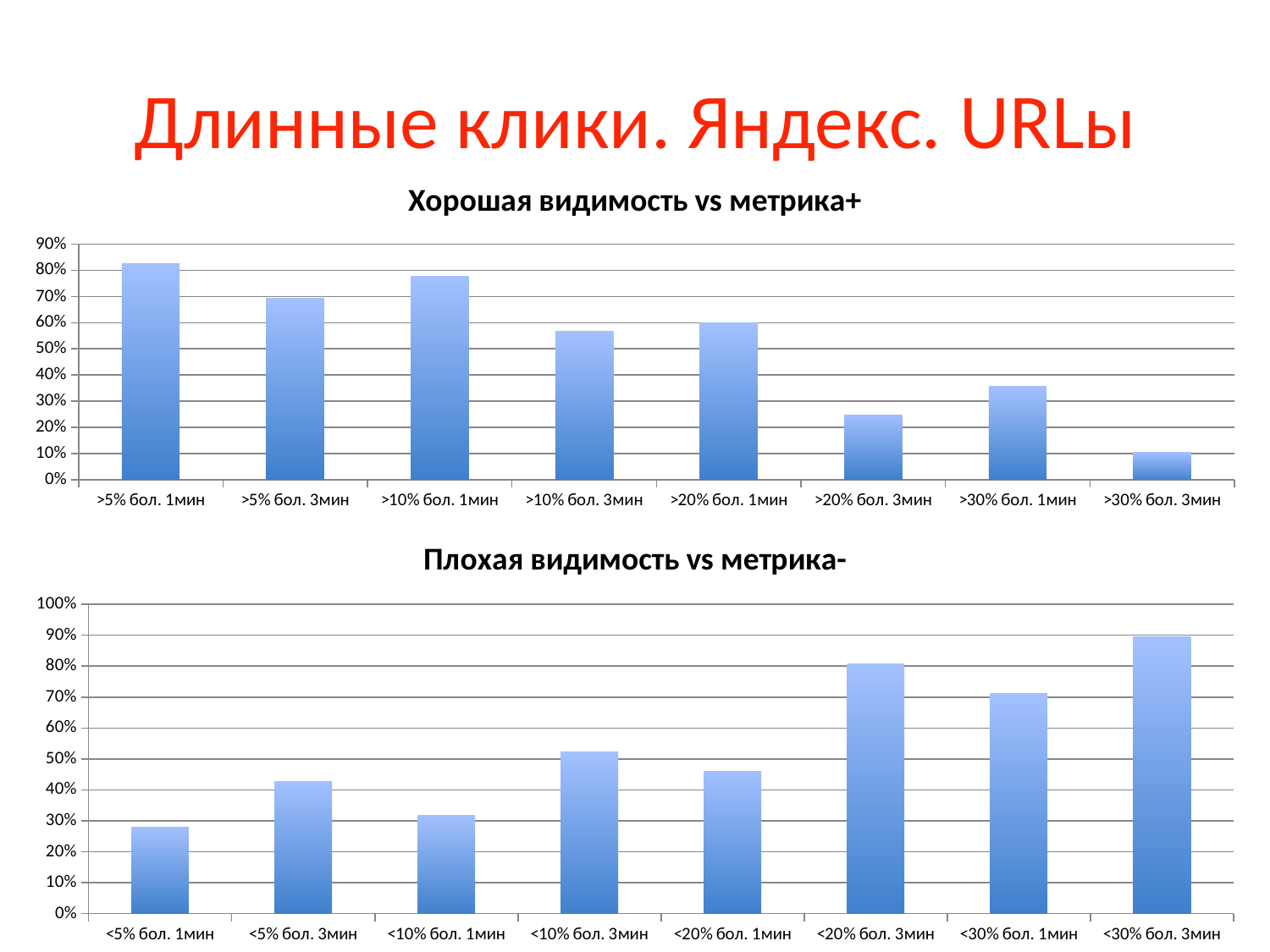
In the bottom chart "Плохая видимость vs метрика-", which is larger: the value for "<5% бол. 1мин" or the value for "<5% бол. 3мин"? <5% бол. 3мин What kind of chart is the top chart titled "Хорошая видимость vs метрика+"? bar chart In the top chart "Хорошая видимость vs метрика+", is the value for ">20% бол. 3мин" greater or less than 30%? less In the bottom chart "Плохая видимость vs метрика-", which category has the highest value? <30% бол. 3мин In the top chart "Хорошая видимость vs метрика+", which is larger: the value for ">5% бол. 3мин" or the value for ">10% бол. 3мин"? >5% бол. 3мин How many categories are shown on the x axis of the top chart "Хорошая видимость vs метрика+"? 8 In the top chart "Хорошая видимость vs метрика+", is the value for ">10% бол. 1мин" greater or less than 70%? greater How many categories are shown on the x axis of the bottom chart "Плохая видимость vs метрика-"? 8 What is the title of the bottom chart on the slide? Плохая видимость vs метрика- In the top chart "Хорошая видимость vs метрика+", which category has the lowest value? >30% бол. 3мин In the top chart "Хорошая видимость vs метрика+", which category has the highest value? >5% бол. 1мин In the bottom chart "Плохая видимость vs метрика-", is the value for "<20% бол. 3мин" greater or less than 70%? greater